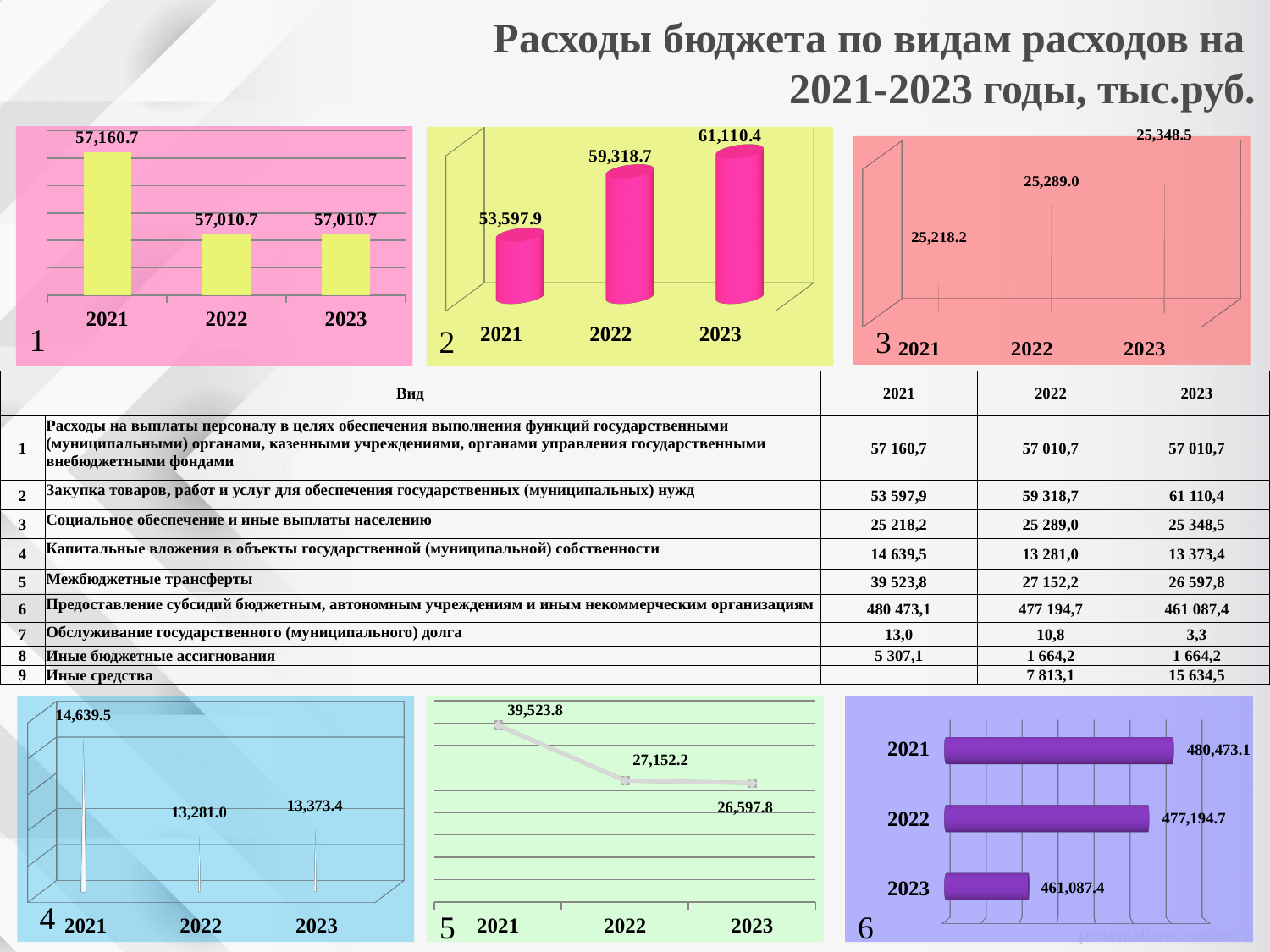
In chart 6 (bottom-right, purple), do the values rise or fall from 2021 to 2023? Fall In chart 5 (bottom-middle, green), what is the value for 2021? 39,523.8 In chart 2 (top-middle, yellow), what is the difference between the 2023 and 2021 values? 7,512.5 In chart 3 (top-right, red), what is the value for 2023? 25,348.5 In chart 6 (bottom-right, purple), what is the value for 2023? 461,087.4 In chart 1 (top-left, pink), what is the value for 2021? 57,160.7 In chart 4 (bottom-left, blue), which year has the lowest value? 2022 In chart 2 (top-middle, yellow), which year has the highest value? 2023 How many years are shown on the x axis of chart 4 (bottom-left, blue)? 3 In chart 1 (top-left, pink), which is larger: the value for 2021 or the value for 2022? 2021 What kind of chart is chart 5 (bottom-middle, green)? Line chart In chart 2 (top-middle, yellow), what is the value for 2022? 59,318.7